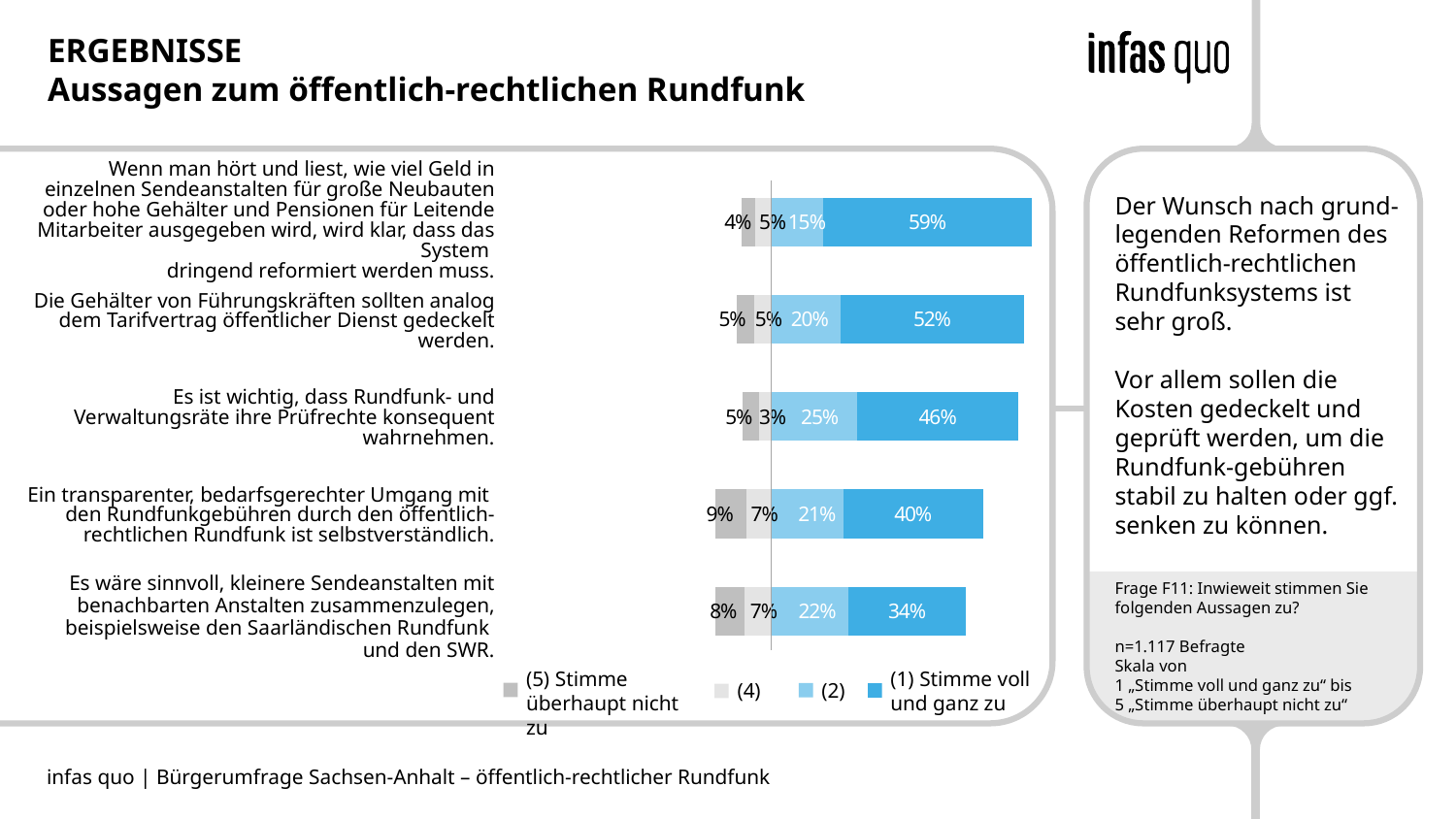
Which statement has the lowest "(1) Stimme voll und ganz zu" share? Es wäre sinnvoll, kleinere Sendeanstalten mit benachbarten Anstalten zusammenzulegen, beispielsweise den Saarländischen Rundfunk und den SWR. Which is larger: the "(2)" value for the statement about Rundfunk- und Verwaltungsräte exercising their audit rights, or the "(2)" value for the statement about merging smaller broadcasters? Rundfunk- und Verwaltungsräte (25%) What share of respondents answered "(1) Stimme voll und ganz zu" for the statement that the system must urgently be reformed ("Wenn man hört und liest...")? 59% What is the total of the four printed segments for the statement "Es wäre sinnvoll, kleinere Sendeanstalten mit benachbarten Anstalten zusammenzulegen..."? 71% What is the "(5) Stimme überhaupt nicht zu" value for the statement "Ein transparenter, bedarfsgerechter Umgang mit den Rundfunkgebühren..."? 9% Which statement has the highest "(1) Stimme voll und ganz zu" share? Wenn man hört und liest, wie viel Geld in einzelnen Sendeanstalten ... dringend reformiert werden muss. What is the difference between the "(1) Stimme voll und ganz zu" values for the statement about merging smaller broadcasters (34%) and the statement about capping executive salaries (52%)? 18 percentage points How many statements (categories) are plotted in the chart? 5 What is the "(4)" value for the statement "Es ist wichtig, dass Rundfunk- und Verwaltungsräte ihre Prüfrechte konsequent wahrnehmen"? 3% What kind of chart is shown on the slide? Stacked bar chart What is the "(2)" value for the statement "Die Gehälter von Führungskräften sollten analog dem Tarifvertrag öffentlicher Dienst gedeckelt werden"? 20% How many series does the chart legend list? 4